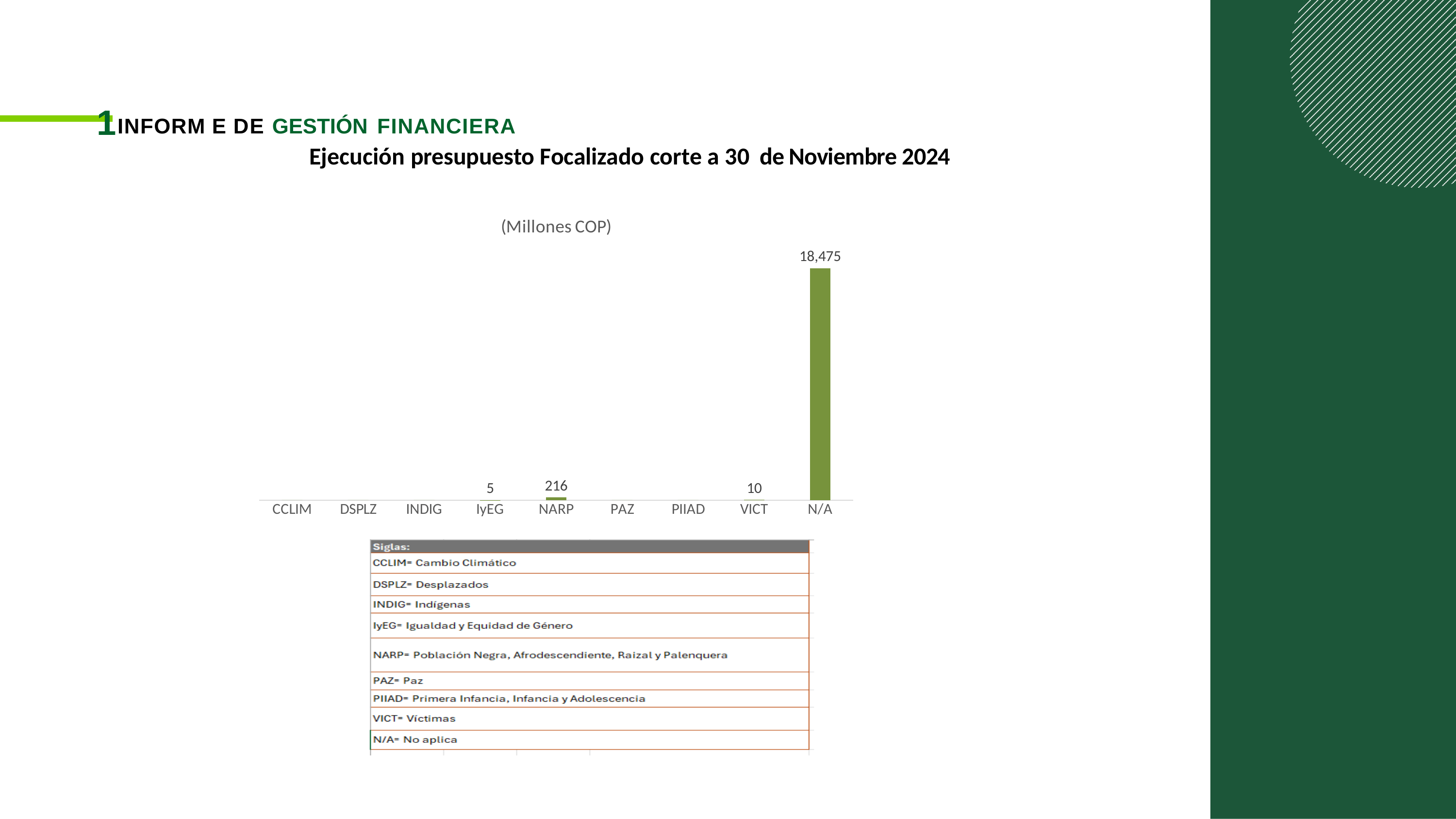
What is the value for IyEG in the chart? 5 What is the difference between the values for N/A and NARP? 18,259 What is the difference between the values for NARP and VICT? 206 Which is larger, the value for NARP or the value for VICT? NARP What is the value for NARP in the chart? 216 What is the difference between the values for VICT and IyEG? 5 How many categories are shown on the x axis of the chart? 9 What unit is given in the chart's title? Millones COP What kind of chart is shown on the slide? Bar chart What is the value for VICT in the chart? 10 What is the value for N/A in the chart? 18,475 Which category has the highest value in the chart? N/A